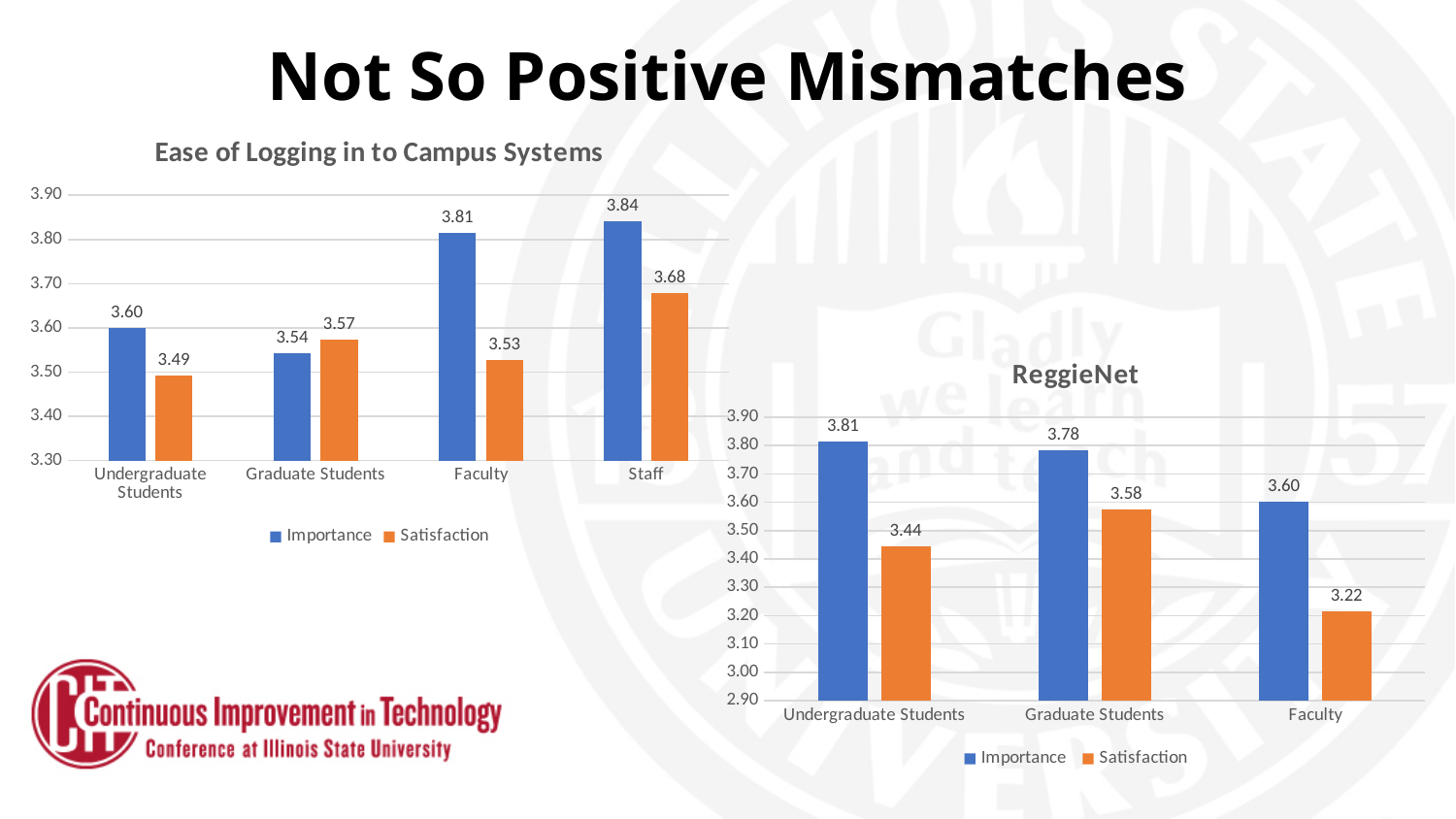
In the 'ReggieNet' chart, what is the difference between Importance and Satisfaction for Undergraduate Students? 0.37 In the 'Ease of Logging in to Campus Systems' chart, how many categories are shown on the x axis? 4 In the 'Ease of Logging in to Campus Systems' chart, what is the Satisfaction value for Undergraduate Students? 3.49 In the 'ReggieNet' chart, what is the Importance value for Graduate Students? 3.78 In the 'Ease of Logging in to Campus Systems' chart, what is the Importance value for Staff? 3.84 In the 'Ease of Logging in to Campus Systems' chart, what is the difference between Importance and Satisfaction for Faculty? 0.28 In the 'Ease of Logging in to Campus Systems' chart, which category has the lowest Satisfaction value? Undergraduate Students In the 'ReggieNet' chart, which category has the lowest Satisfaction value? Faculty In the 'ReggieNet' chart, is the Importance value for Undergraduate Students larger or smaller than the Importance value for Faculty? larger In the 'ReggieNet' chart, what is the Satisfaction value for Faculty? 3.22 In the 'Ease of Logging in to Campus Systems' chart, which category has the highest Importance value? Staff How many series does the legend of the 'ReggieNet' chart list? 2